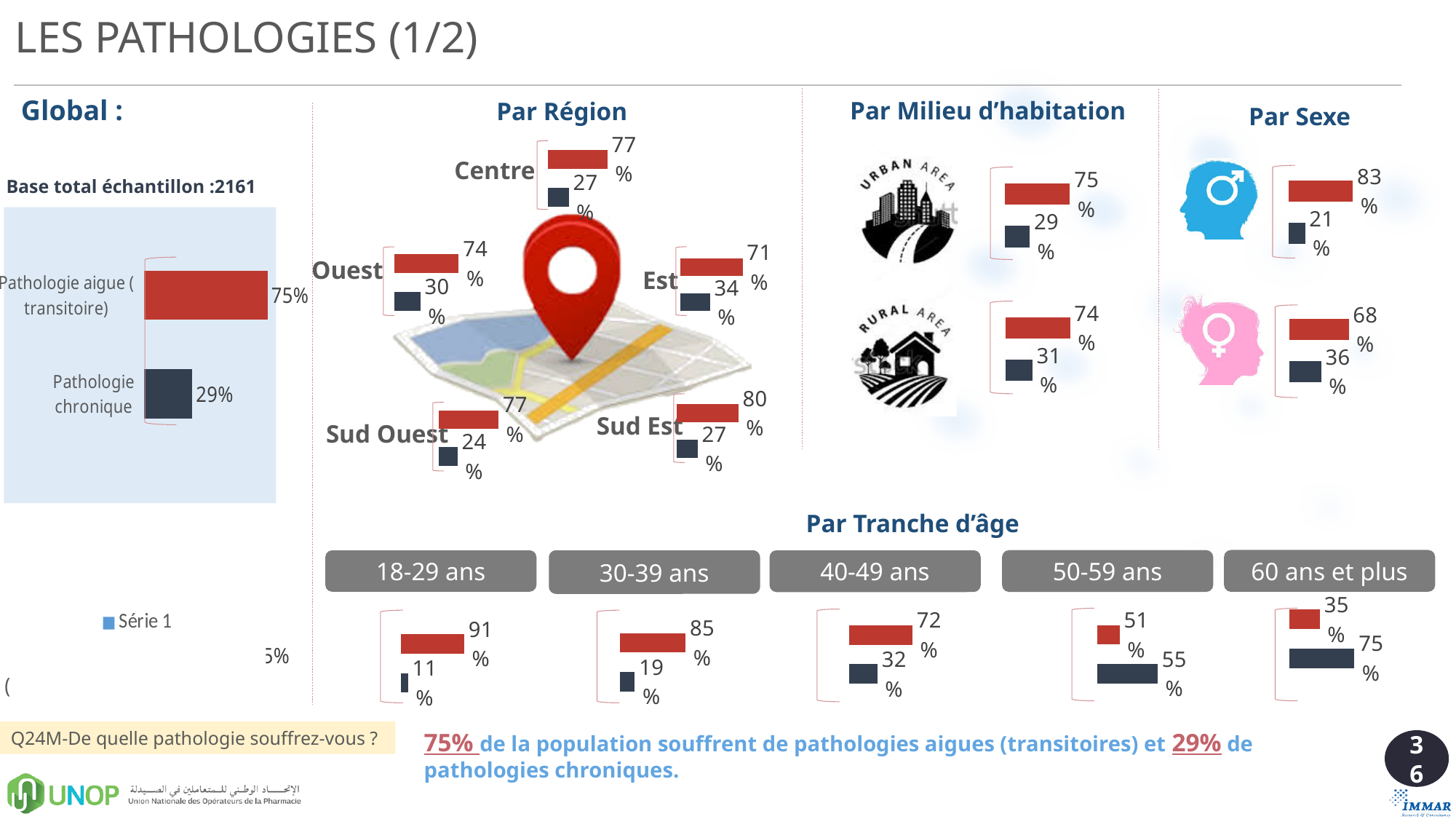
What kind of chart is the Global chart? bar chart In the Par Région chart, which region has the lowest dark bar value? Sud Ouest In the Par Région chart, what is the red bar value for Sud Est? 80% In the Par Tranche d'âge chart, what is the red bar value for 18-29 ans? 91% In the Global chart, what is the difference between the Pathologie aigue (transitoire) value and the Pathologie chronique value? 46% In the Par Sexe chart, which is larger, the red bar value for men or for women? men In the Global chart, what is the value for Pathologie chronique? 29% In the Global chart, what is the value for Pathologie aigue (transitoire)? 75% In the Par Milieu d'habitation chart, what is the dark bar value for Rural Area? 31% In the Par Région chart, which region has the highest red bar value? Sud Est In the Par Tranche d'âge chart, how many age groups are shown? 5 In the Par Sexe chart, what is the difference between the red bar values for men and women? 15%